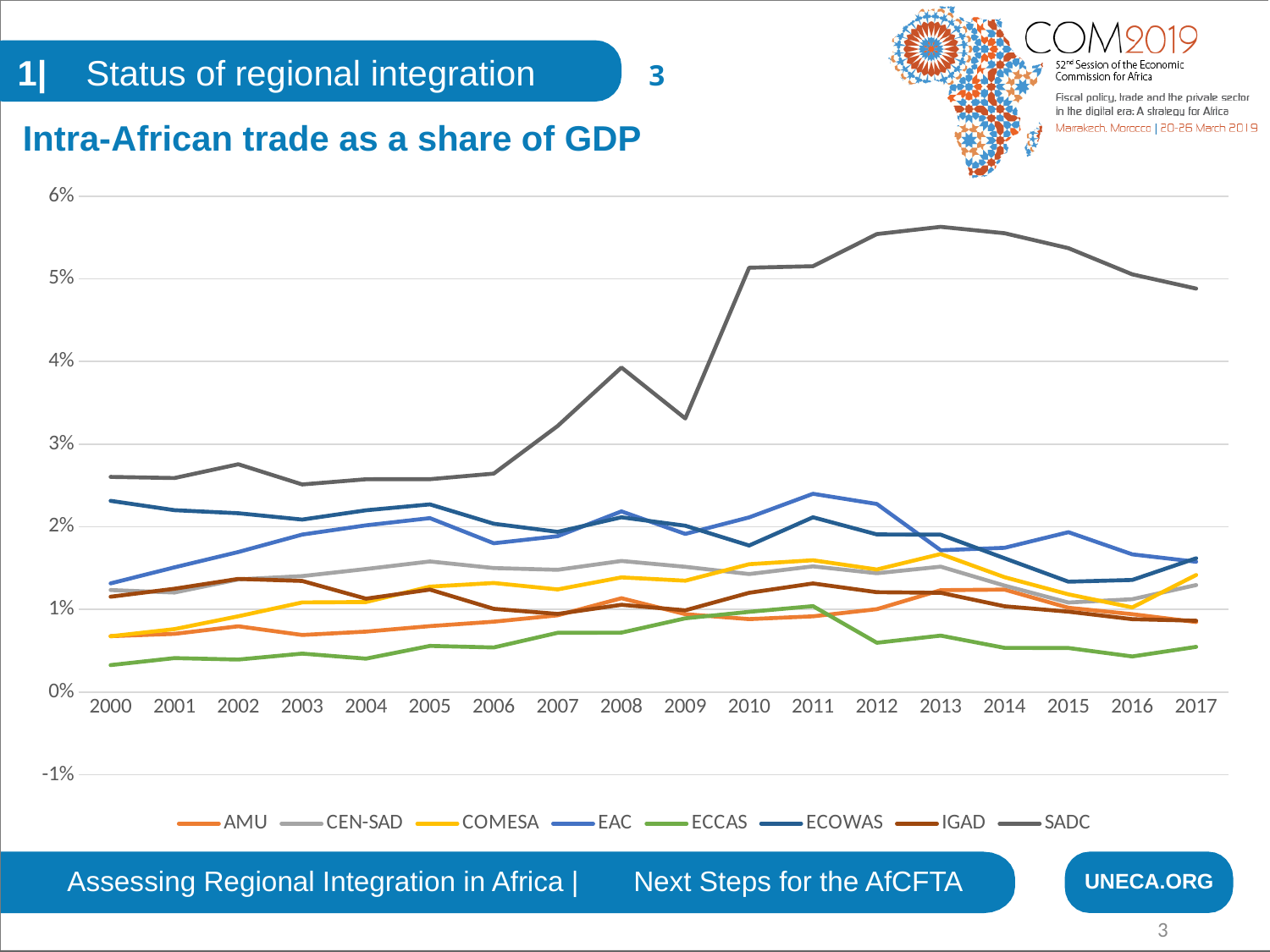
How many years are shown along the x axis? 18 What kind of chart is shown on the slide? line chart Which regional community has the lowest intra-African trade as a share of GDP in 2000? ECCAS Is the value for SADC in 2013 greater or less than 5%? greater Which is larger in 2010, the value for SADC or the value for EAC? SADC Is the value for EAC in 2011 greater or less than 2%? greater How many series does the legend list? 8 Is the value for SADC in 2008 greater or less than 3%? greater Which regional community has the highest intra-African trade as a share of GDP in 2017? SADC What is the title of the chart? Intra-African trade as a share of GDP Does the SADC line rise or fall between 2013 and 2017? fall